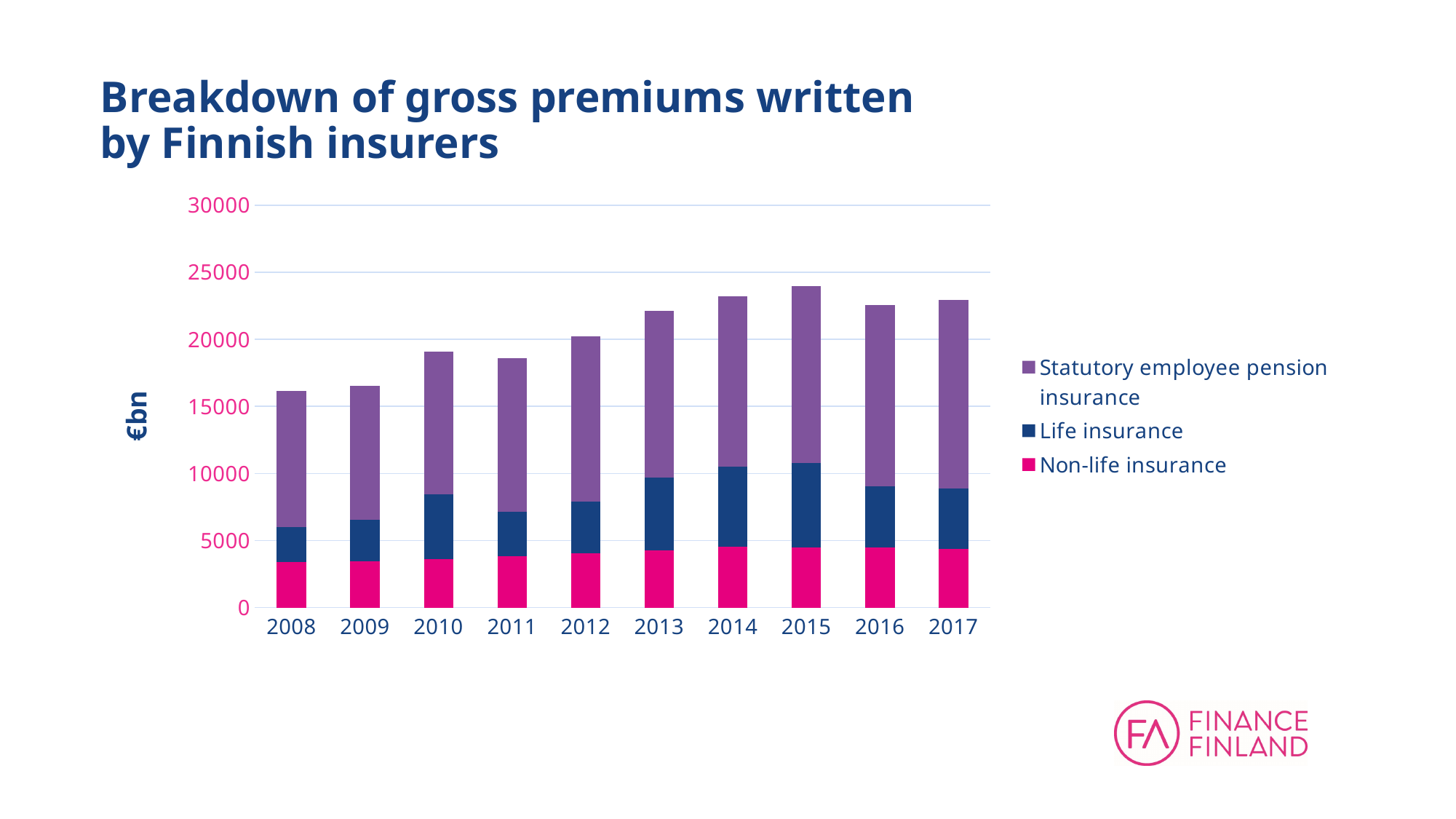
Is the total for 2008 greater or less than 20000? less Is the total for 2010 greater or less than 20000? less Do the total gross premiums generally rise or fall from 2008 to 2015? Rise What kind of chart is shown on the slide? Stacked bar chart Which year has the highest total gross premiums written? 2015 Is the total for 2013 greater or less than 20000? greater How many series does the legend list? 3 What is the label on the y axis of the chart? €bn How many years are shown on the x axis of the chart? 10 Which year has the larger total, 2008 or 2015? 2015